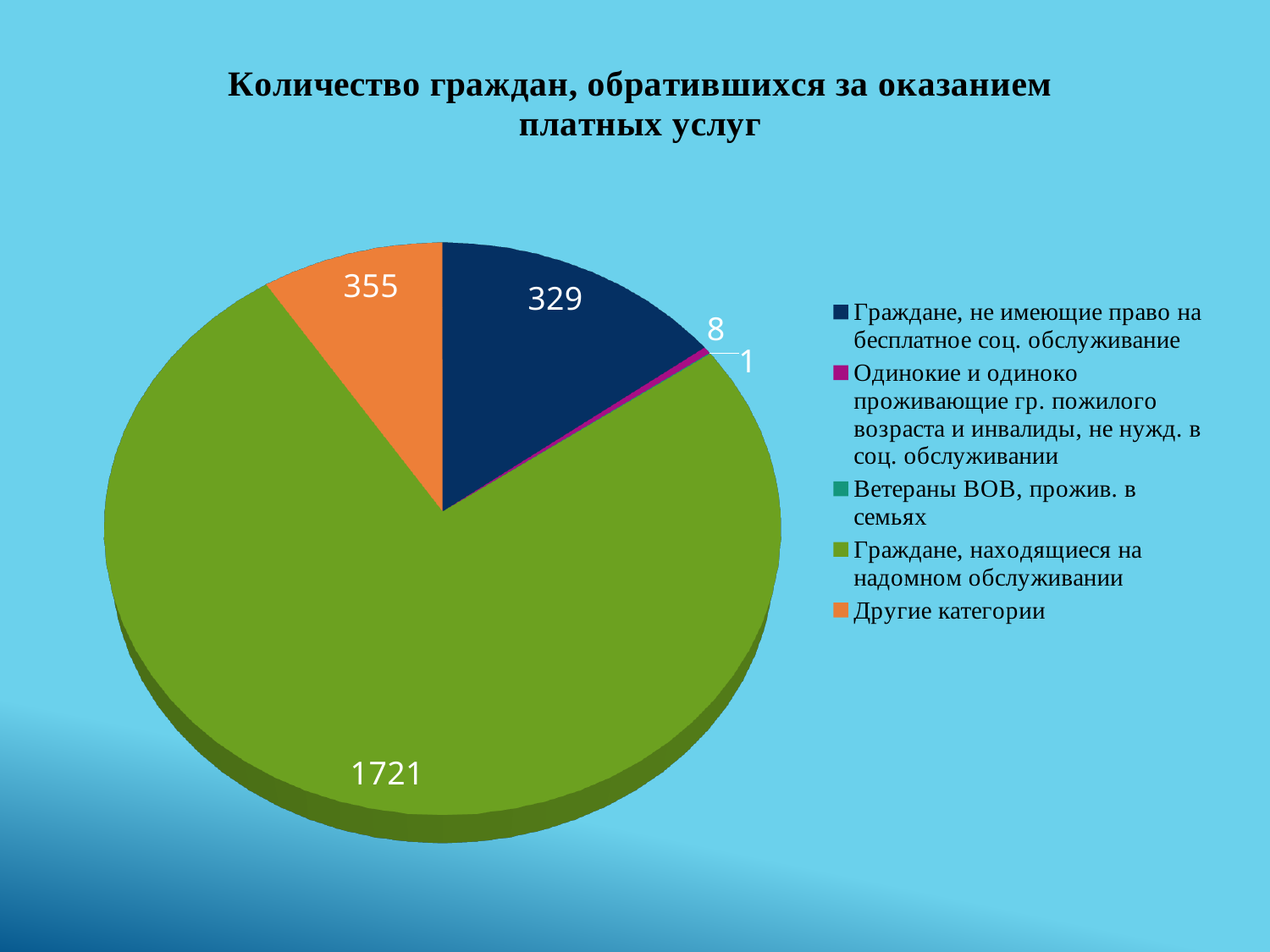
What is the value for "Другие категории"? 355 What is the difference between the values for "Другие категории" and "Граждане, не имеющие право на бесплатное соц. обслуживание"? 26 Which category has the largest slice of the pie? Граждане, находящиеся на надомном обслуживании Which category has the smallest slice of the pie? Ветераны ВОВ, прожив. в семьях What is the value for "Граждане, находящиеся на надомном обслуживании"? 1721 What is the value for "Ветераны ВОВ, прожив. в семьях"? 1 What is the value for "Одинокие и одиноко проживающие гр. пожилого возраста и инвалиды, не нужд. в соц. обслуживании"? 8 How many categories does the pie chart have? 5 What is the value for "Граждане, не имеющие право на бесплатное соц. обслуживание"? 329 What is the title of the chart? Количество граждан, обратившихся за оказанием платных услуг What type of chart is shown on the slide? Pie chart Which is larger: the value for "Другие категории" or the value for "Граждане, не имеющие право на бесплатное соц. обслуживание"? Другие категории